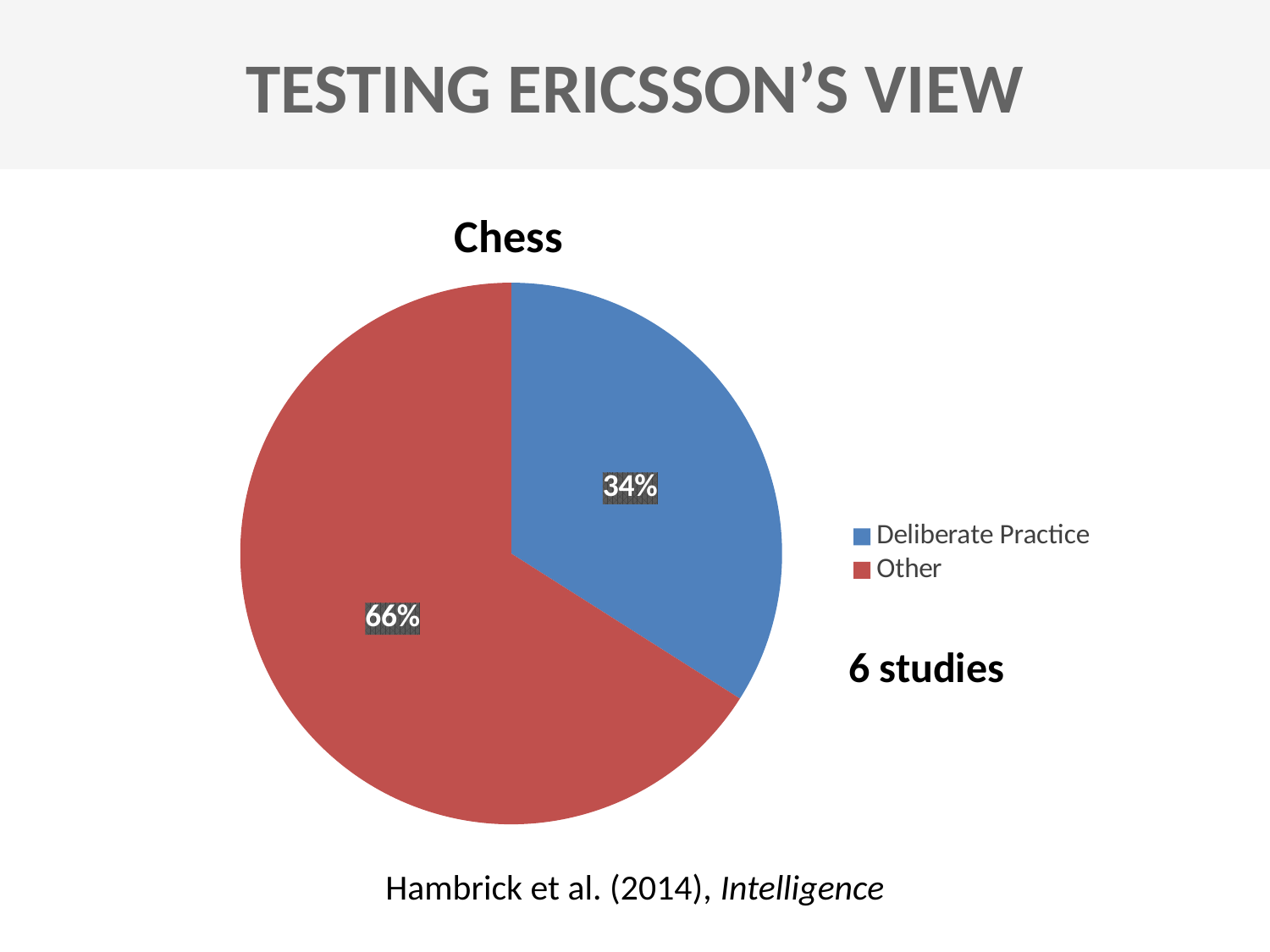
What type of chart is shown on the slide? Pie chart Which slice is the smallest? Deliberate Practice How many slices does the pie chart have? 2 What colour is the Deliberate Practice slice? Blue What share of the pie does Deliberate Practice account for? 34% What is the title of the chart? Chess Is the share for Deliberate Practice greater or less than 50%? less How many entries does the legend list? 2 What share of the pie does Other account for? 66% Which is larger, the Deliberate Practice slice or the Other slice? Other What is the difference in percentage points between the Other slice and the Deliberate Practice slice? 32 percentage points Which slice is the largest? Other